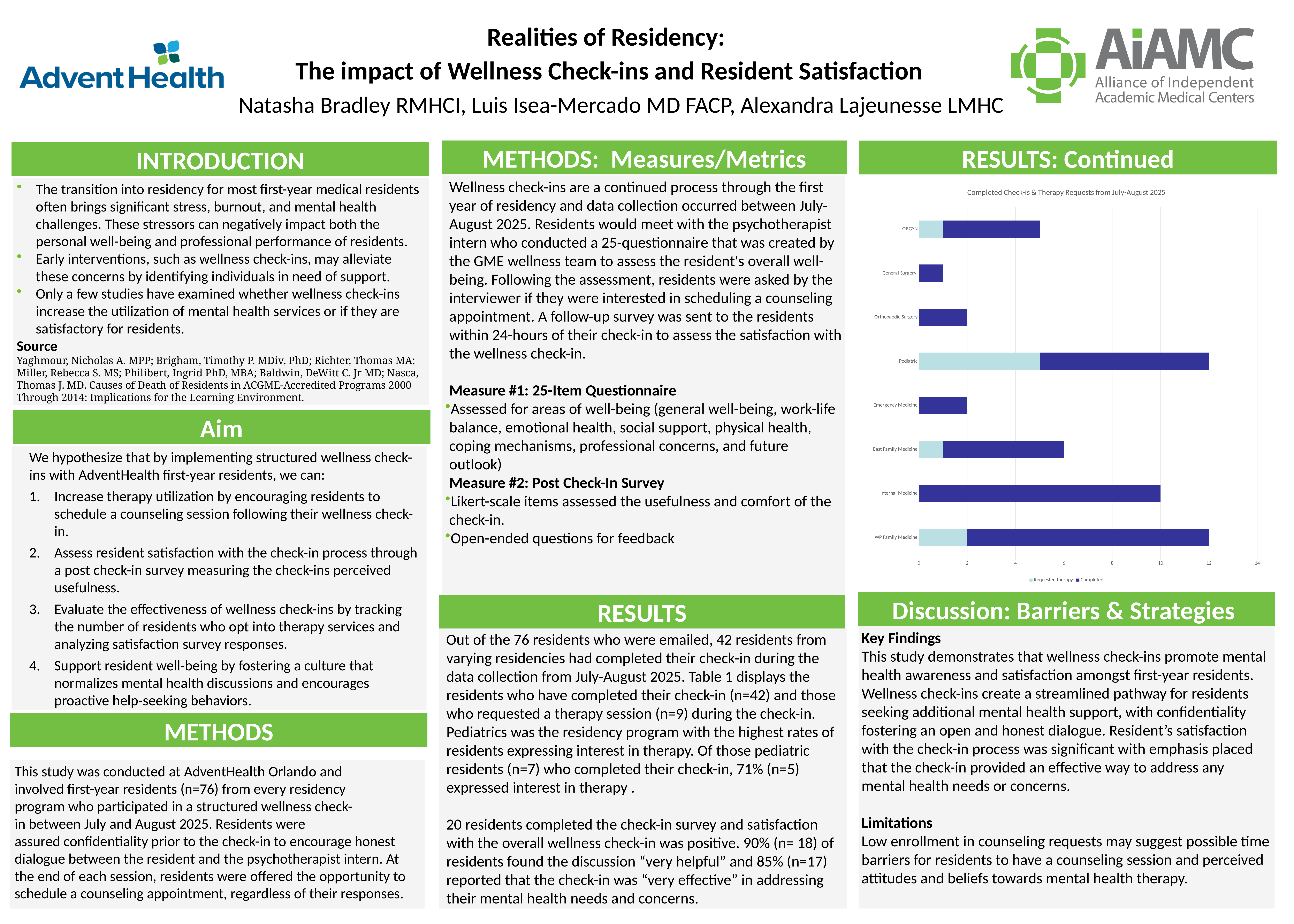
Is the total bar length for Pediatric greater or less than 10? greater What is the title of the chart? Completed Check-is & Therapy Requests from July-August 2025 Which has the longer total bar, Internal Medicine or OBGYN? Internal Medicine How many residency programs are listed on the chart's vertical axis? 8 Is the total bar length for OBGYN greater or less than 6? less Is the total bar length for Internal Medicine greater or less than 8? greater What are the two series named in the chart legend? Requested therapy and Completed Which residency program has the shortest total bar on the chart? General Surgery Which program has the larger Requested therapy segment, Pediatric or WP Family Medicine? Pediatric What kind of chart is shown in the RESULTS: Continued section? Stacked bar chart How many series does the chart legend list? 2